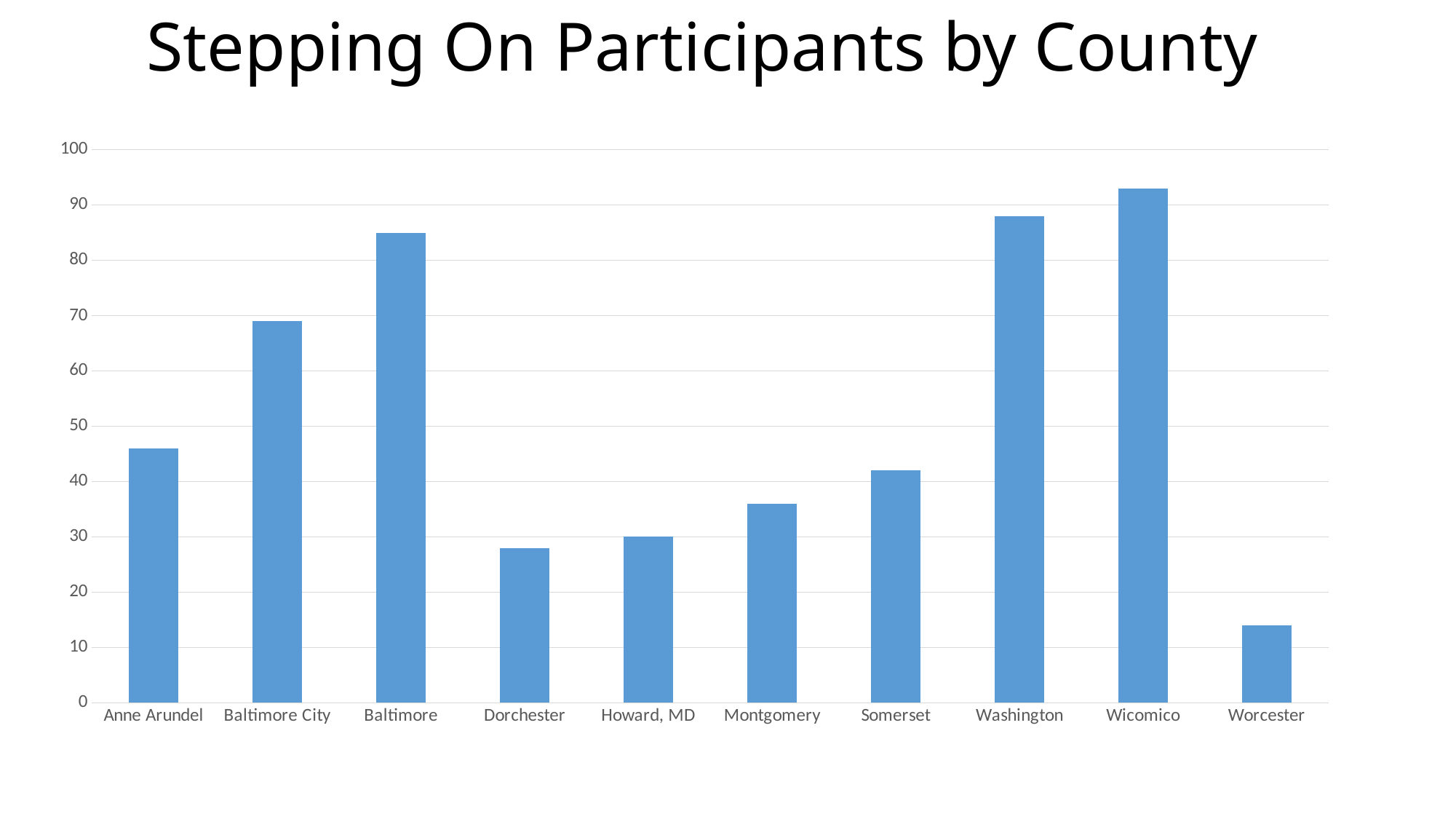
Is the value for Anne Arundel greater or less than 50? less What kind of chart is shown on the slide? bar chart Is the value for Worcester greater or less than 20? less Which county has the lowest number of Stepping On participants? Worcester Which has more participants, Somerset or Montgomery? Somerset What is the title of the chart? Stepping On Participants by County How many counties are shown on the x axis of the chart? 10 Is the value for Washington greater or less than 80? greater Which has more participants, Howard, MD or Dorchester? Howard, MD Which county has the highest number of Stepping On participants? Wicomico Which has more participants, Baltimore or Baltimore City? Baltimore